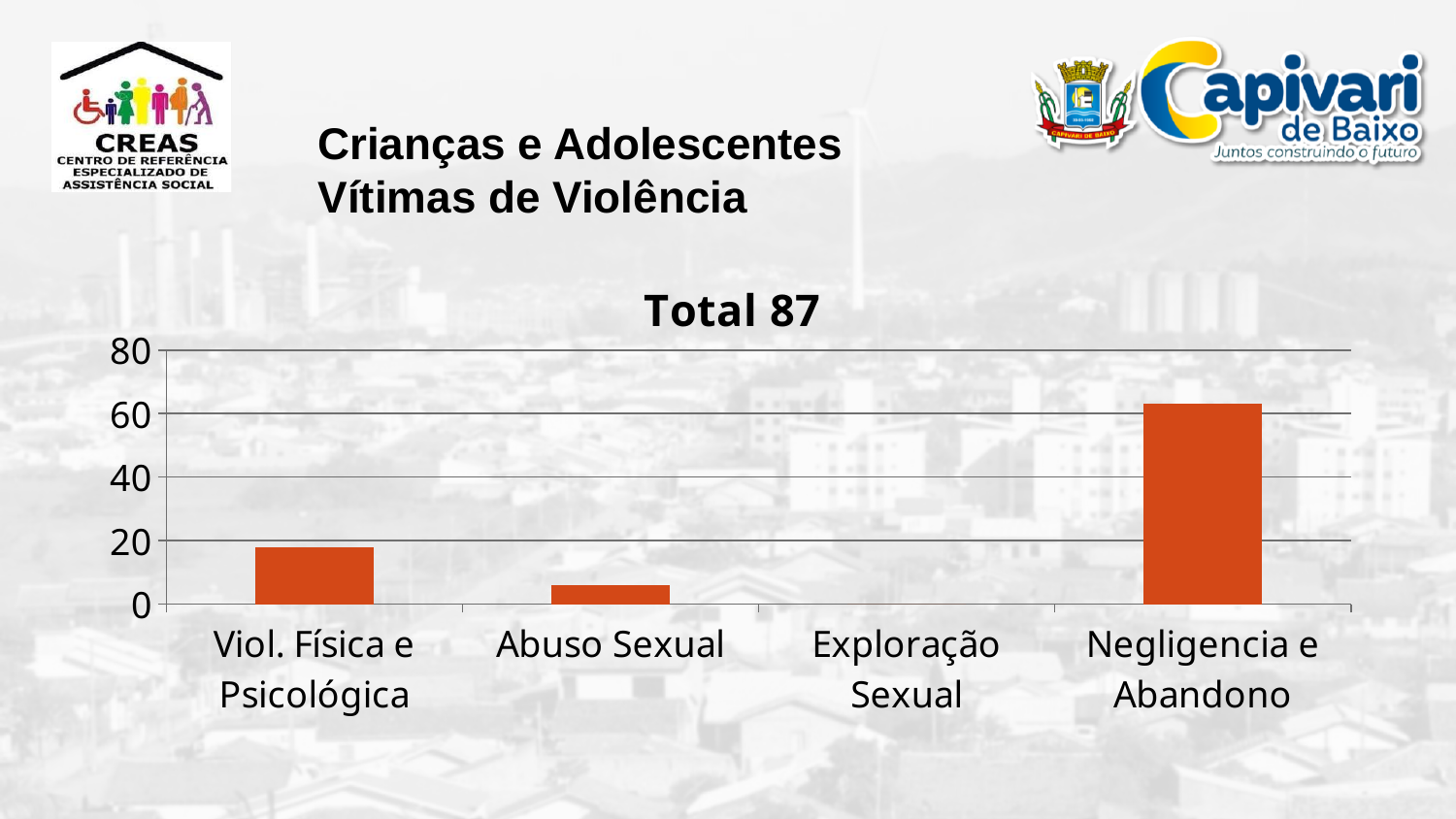
What is the title of the chart? Total 87 Which category has the highest value in the chart? Negligencia e Abandono Is the value for Negligencia e Abandono greater or less than 40? greater Is the value for Abuso Sexual greater or less than 20? less Which category has the lowest value in the chart? Exploração Sexual Is the value for Negligencia e Abandono greater or less than 60? greater Which is larger, the value for Viol. Física e Psicológica or the value for Abuso Sexual? Viol. Física e Psicológica What kind of chart is shown on the slide? bar chart Which is larger, the value for Negligencia e Abandono or the value for Viol. Física e Psicológica? Negligencia e Abandono How many categories are shown on the x axis of the chart? 4 What is the highest value labelled on the vertical axis of the chart? 80